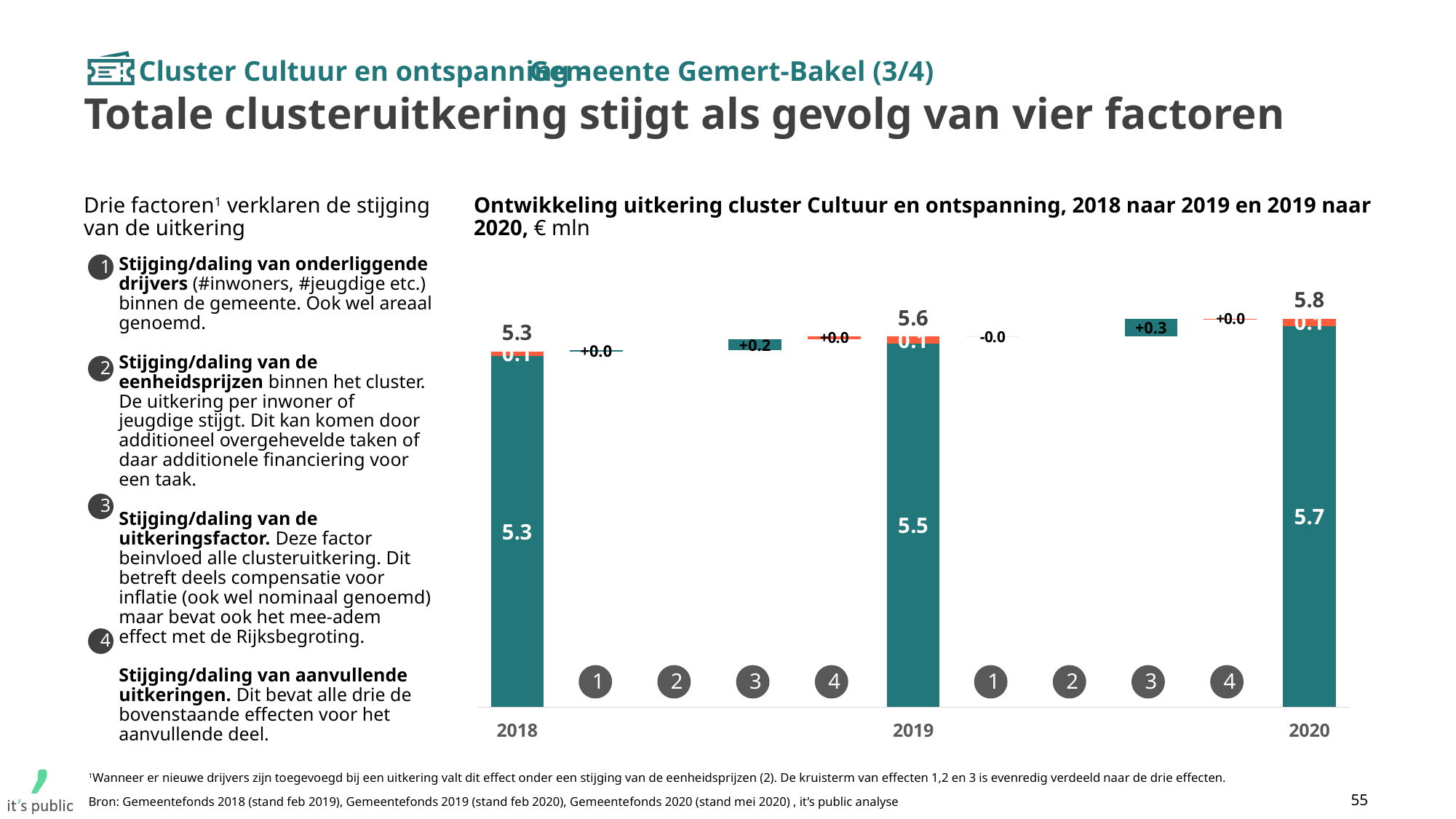
In what unit are the values in the chart expressed, according to the chart title? € mln What is the value of the large teal segment of the 2019 bar? 5.5 Is the total for 2019 larger or smaller than the total for 2018? larger Do the yearly totals rise or fall from 2018 to 2020? rise What is the total uitkering shown for 2018? 5.3 What is the effect of factor 3 in the change from 2019 to 2020? +0.3 What is the value of the large teal segment of the 2020 bar? 5.7 What is the total uitkering shown for 2019? 5.6 What is the total uitkering shown for 2020? 5.8 What is the effect of factor 3 in the change from 2018 to 2019? +0.2 Which year has the highest total uitkering? 2020 What is the difference between the total for 2020 and the total for 2018? 0.5